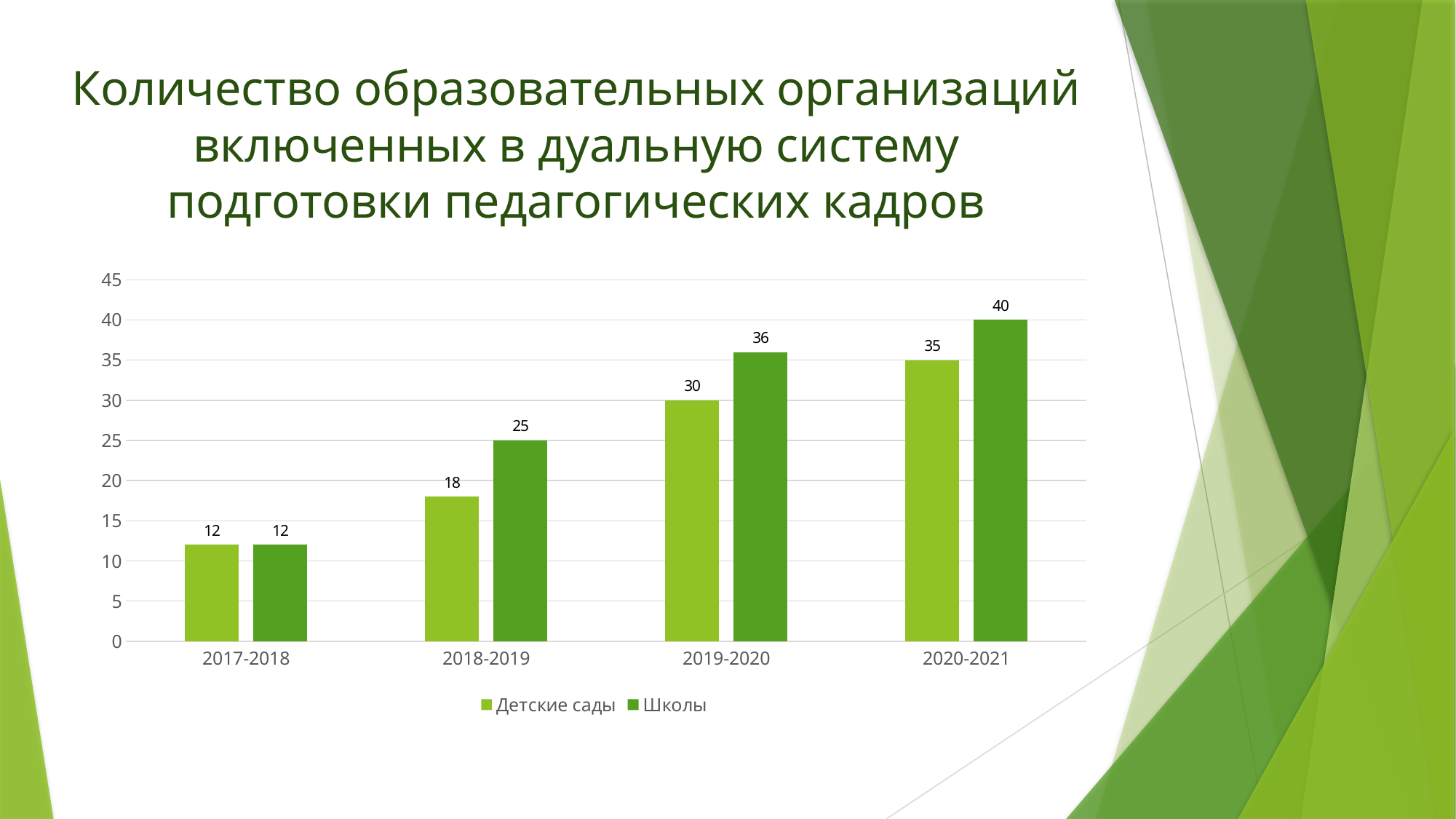
What is the value for Школы in 2020-2021? 40 What are the two series named in the legend? Детские сады and Школы In which year is the value for Детские сады highest? 2020-2021 What kind of chart is shown on the slide? Bar chart What is the difference between Школы and Детские сады in 2019-2020? 6 What is the value for Детские сады in 2018-2019? 18 How many series does the legend list? 2 What is the value for Школы in 2019-2020? 36 In which year is the value for Школы lowest? 2017-2018 How many year categories are shown on the x axis? 4 Which is larger in 2018-2019: Детские сады or Школы? Школы Do the values for Школы rise or fall from 2017-2018 to 2020-2021? Rise